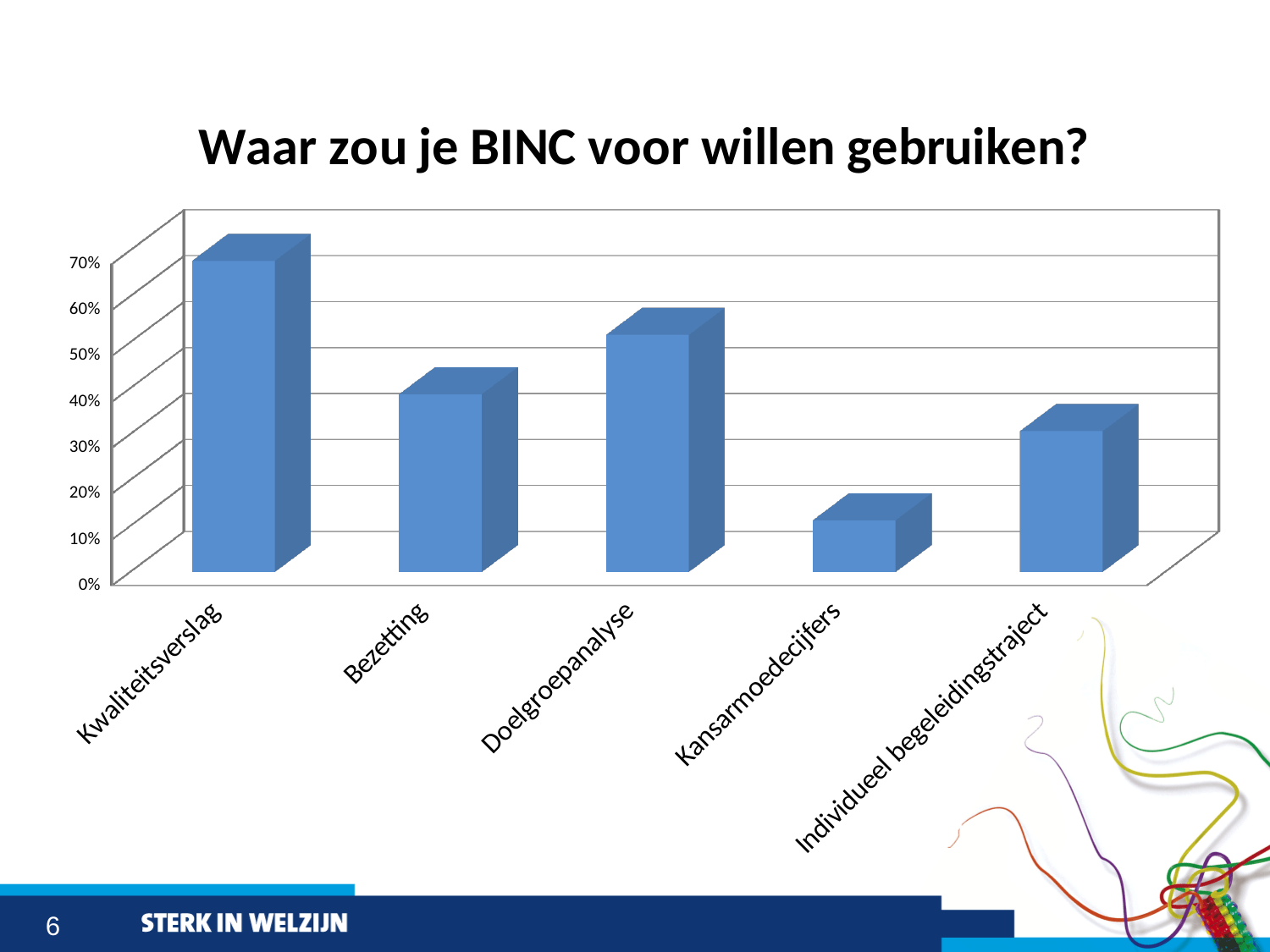
Is the value for Doelgroepanalyse greater or less than 40%? greater Is the value for Kwaliteitsverslag greater or less than 60%? greater Is the value for Bezetting greater or less than 30%? greater What kind of chart is shown on the slide? Bar chart What is the title of the chart? Waar zou je BINC voor willen gebruiken? Which is larger, the value for Doelgroepanalyse or the value for Bezetting? Doelgroepanalyse Which category has the highest value? Kwaliteitsverslag Which is larger, the value for Kwaliteitsverslag or the value for Individueel begeleidingstraject? Kwaliteitsverslag Which category has the lowest value? Kansarmoedecijfers How many categories are shown on the x axis of the chart? 5